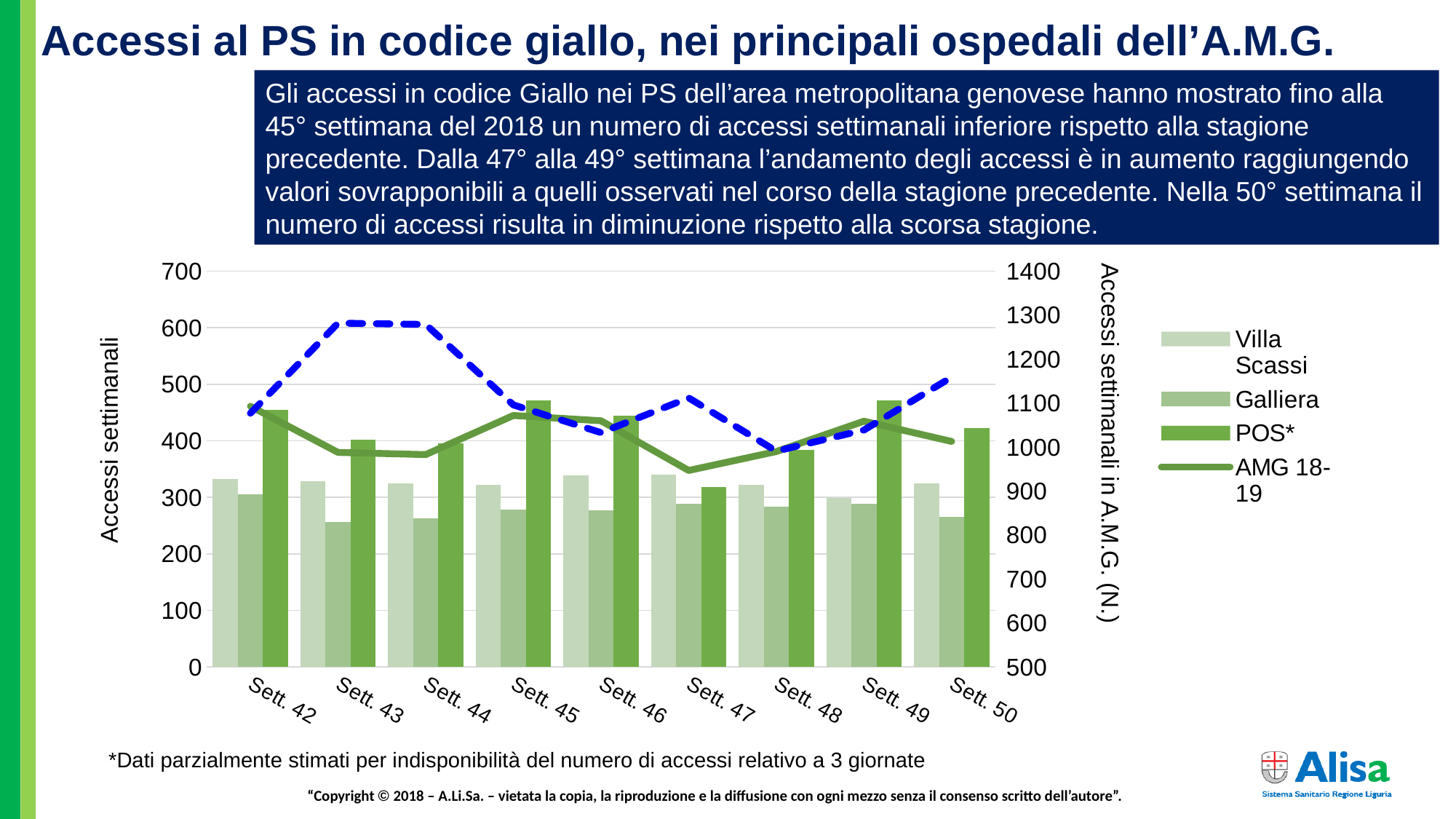
How many series does the chart legend list? 4 How many weeks (categories) are shown on the x axis of the chart? 9 Is the POS* value for Sett. 47 greater or less than 400 on the left axis? less In which week is the POS* bar lowest? Sett. 47 What kind of chart is shown on the slide? Combined bar and line chart Is the Villa Scassi value for Sett. 42 greater or less than 300 on the left axis? greater At Sett. 45, which bar is taller: POS* or Galliera? POS* What is the title of the right-hand vertical axis? Accessi settimanali in A.M.G. (N.) Is the Galliera value for Sett. 43 greater or less than 300 on the left axis? less Does the AMG 18-19 line rise or fall from Sett. 47 to Sett. 49? rise